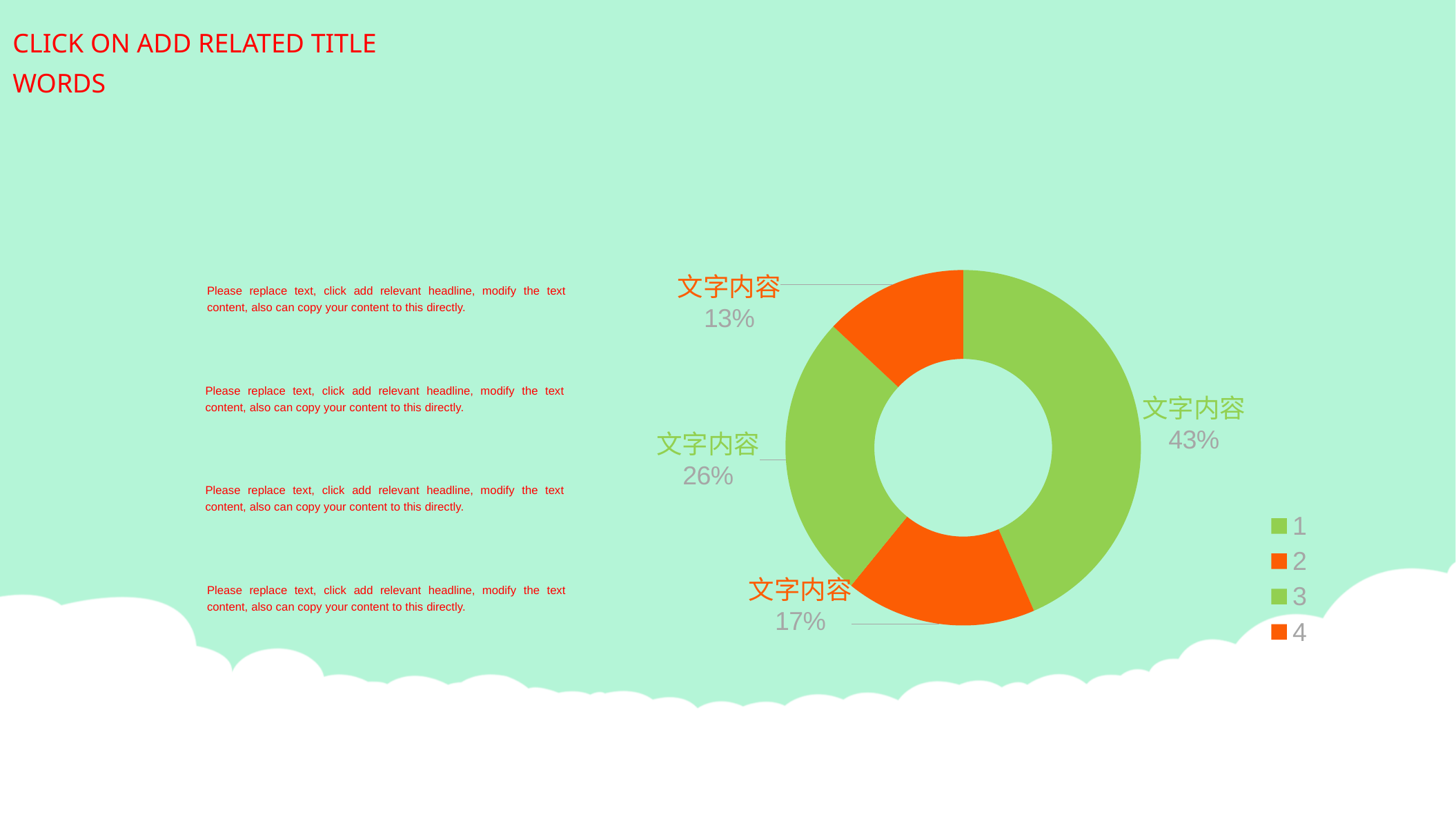
Which slice has the smallest share of the doughnut chart? 4 (13%) How many entries does the legend list? 4 What percentage is shown for legend category 4? 13% Which is larger, the slice labelled 26% or the slice labelled 17%? 26% Which slice has the largest share of the doughnut chart? 1 (43%) What percentage is shown for legend category 3? 26% What colour is the slice for legend category 2? orange What is the difference in percentage points between the largest slice (43%) and the smallest slice (13%)? 30 What percentage is shown for legend category 1? 43% What kind of chart is shown on the slide? doughnut chart How many slices does the doughnut chart have? 4 What percentage is shown for legend category 2? 17%